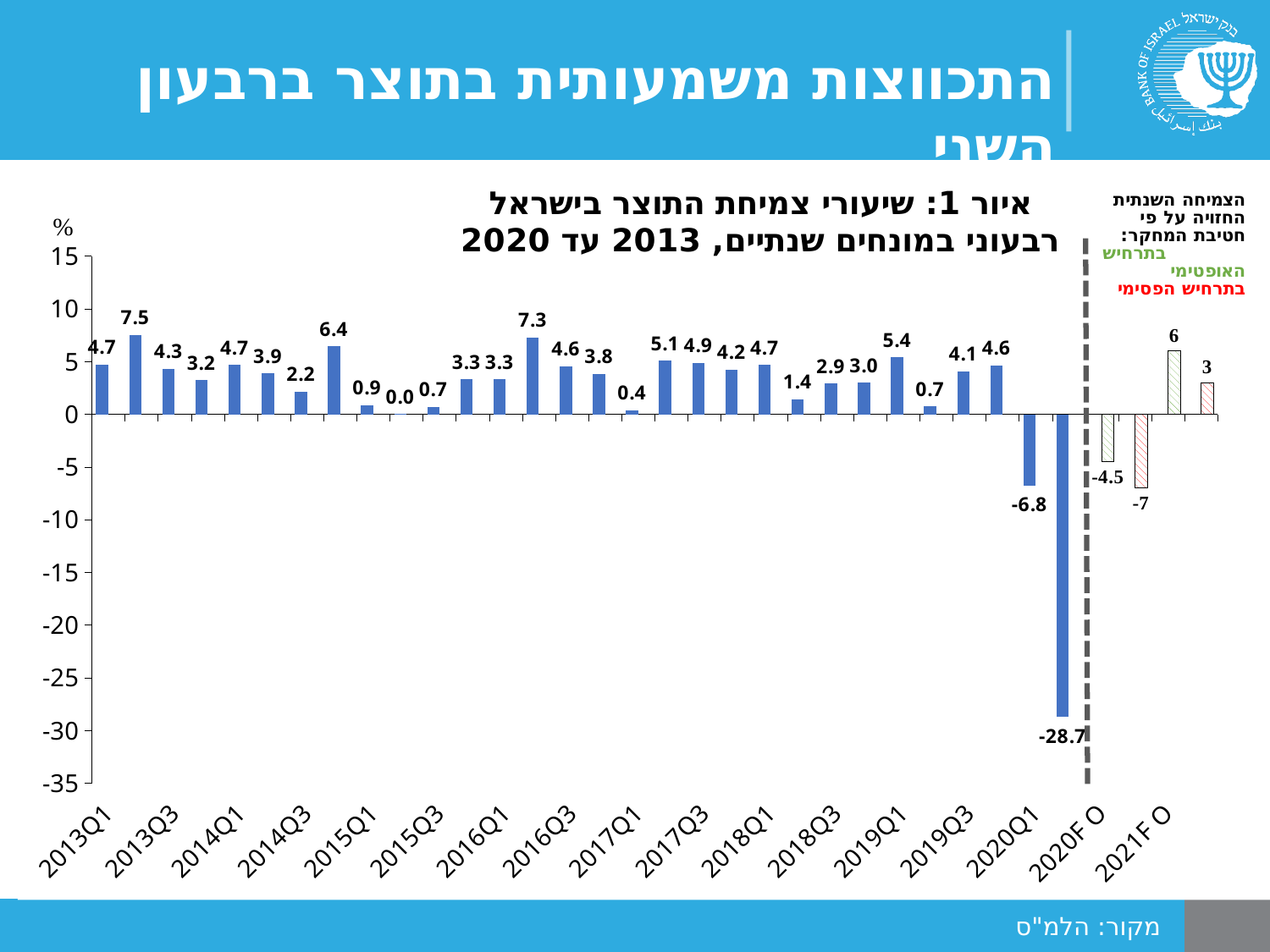
What is the value for 2019Q1? 5.4 What is the highest value shown on the chart? 7.5 Is the value for 2020Q1 greater or less than -5? less What kind of chart is shown on the slide? bar chart What is the difference between the values for 2019Q1 and 2018Q1? 0.7 What unit is shown at the top of the y axis? % Which is larger, the value for 2016Q3 or the value for 2018Q3? 2016Q3 What is the pessimistic scenario forecast value for 2020F? -7 What is the value for 2017Q1? 0.4 What is the value for 2020Q1? -6.8 What is the value for 2013Q1? 4.7 What is the lowest value shown on the chart? -28.7